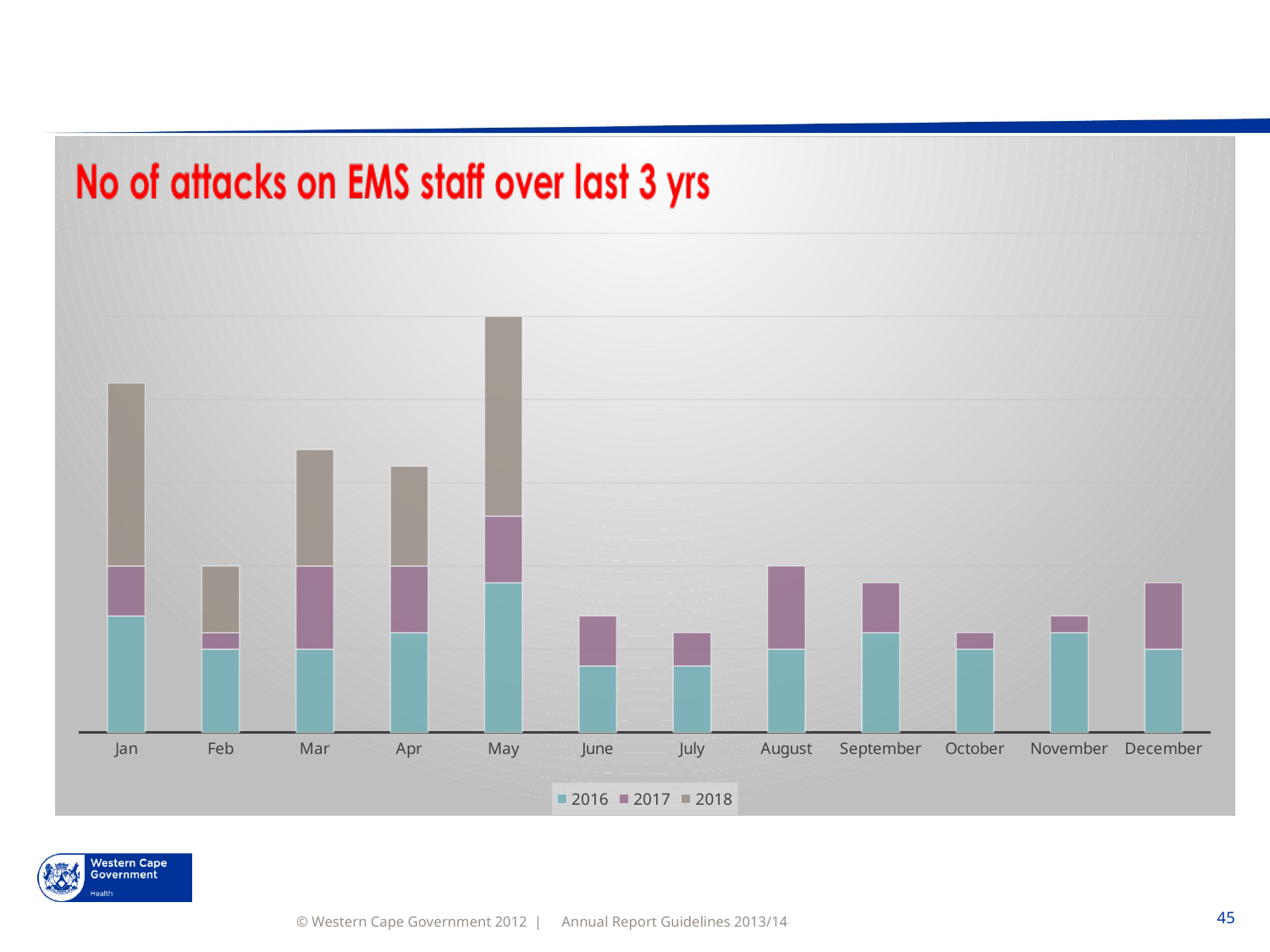
Does the total stacked bar rise or fall from Jan to Feb? Fall Which is larger: the 2016 segment for May or the 2016 segment for Feb? May What type of chart is shown on the slide? Stacked bar chart How many months have a 2018 segment in their bar? 5 Which is larger: the total stacked bar for Mar or the total for June? Mar Which years are listed in the legend? 2016, 2017, 2018 How many series does the legend list? 3 Which month has the tallest stacked bar overall? May What is the title of the chart? No of attacks on EMS staff over last 3 yrs Is the total stacked bar for Jan larger or smaller than the total for Feb? Larger Which month has the largest 2016 segment? May How many months are shown along the x axis? 12